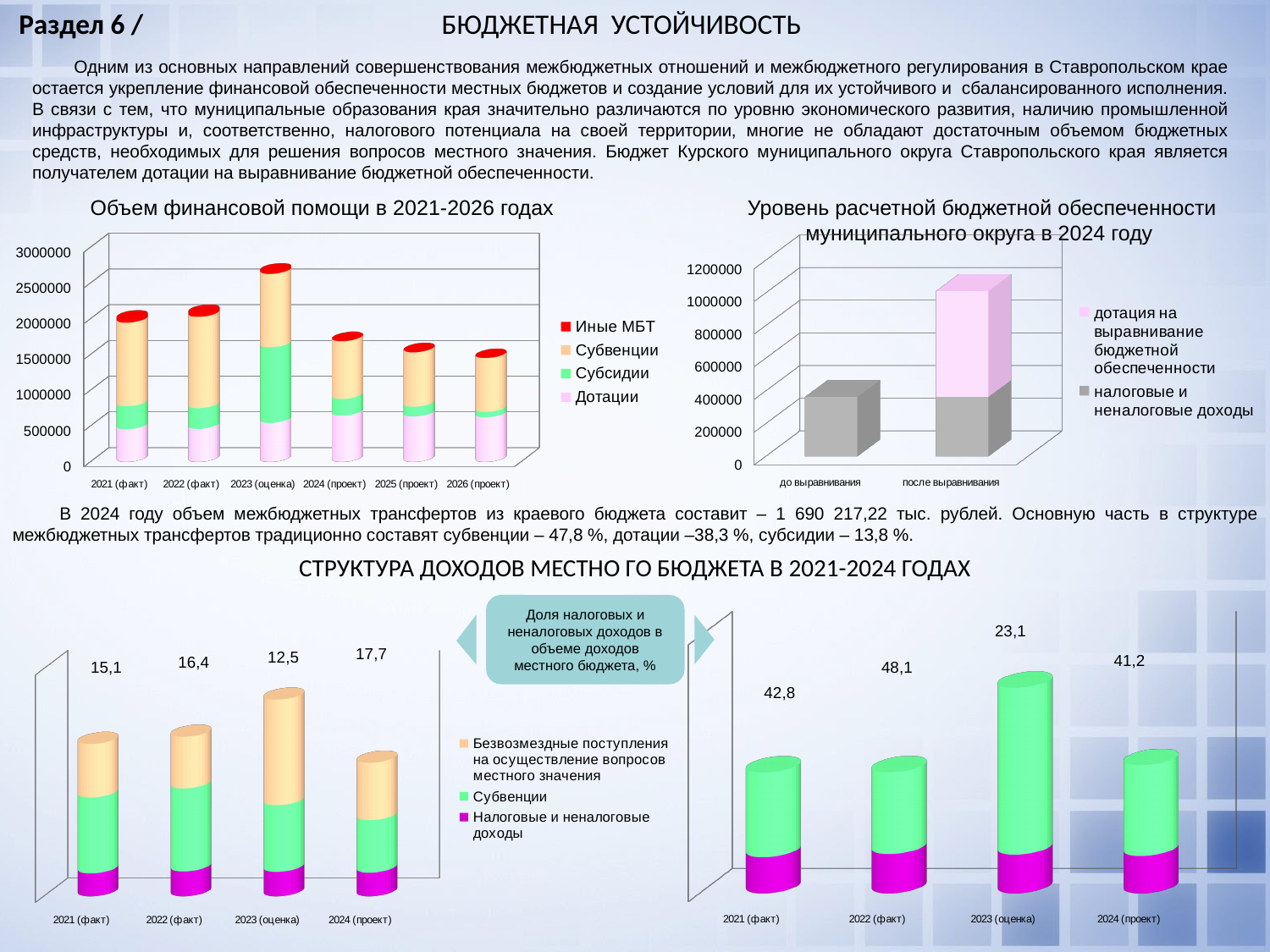
How many categories are shown on the x axis of the chart 'Уровень расчетной бюджетной обеспеченности муниципального округа в 2024 году'? 2 In the bottom-left chart (Структура доходов местного бюджета), what is the difference between the labelled values for 2024 (проект) and 2021 (факт)? 2,6 In the chart 'Уровень расчетной бюджетной обеспеченности муниципального округа в 2024 году', is the total bar for 'после выравнивания' greater or less than 800000? greater In the chart 'Объем финансовой помощи в 2021-2026 годах', is the total for 2024 (проект) greater or less than 2000000? less In the bottom-right chart (Структура доходов местного бюджета), which year has the highest labelled value? 2022 (факт) In the bottom-left chart (Структура доходов местного бюджета), what value is labelled for 2021 (факт)? 15,1 In the bottom-left chart (Структура доходов местного бюджета), which year has the lowest labelled value? 2023 (оценка) In the chart 'Объем финансовой помощи в 2021-2026 годах', which year has the tallest stacked bar? 2023 (оценка) In the chart 'Объем финансовой помощи в 2021-2026 годах', how many series does the legend list? 4 In the chart 'Уровень расчетной бюджетной обеспеченности муниципального округа в 2024 году', which category has the taller bar? после выравнивания In the chart 'Объем финансовой помощи в 2021-2026 годах', is the total for 2023 (оценка) greater or less than 2500000? greater In the bottom-right chart (Структура доходов местного бюджета), what value is labelled for 2023 (оценка)? 23,1